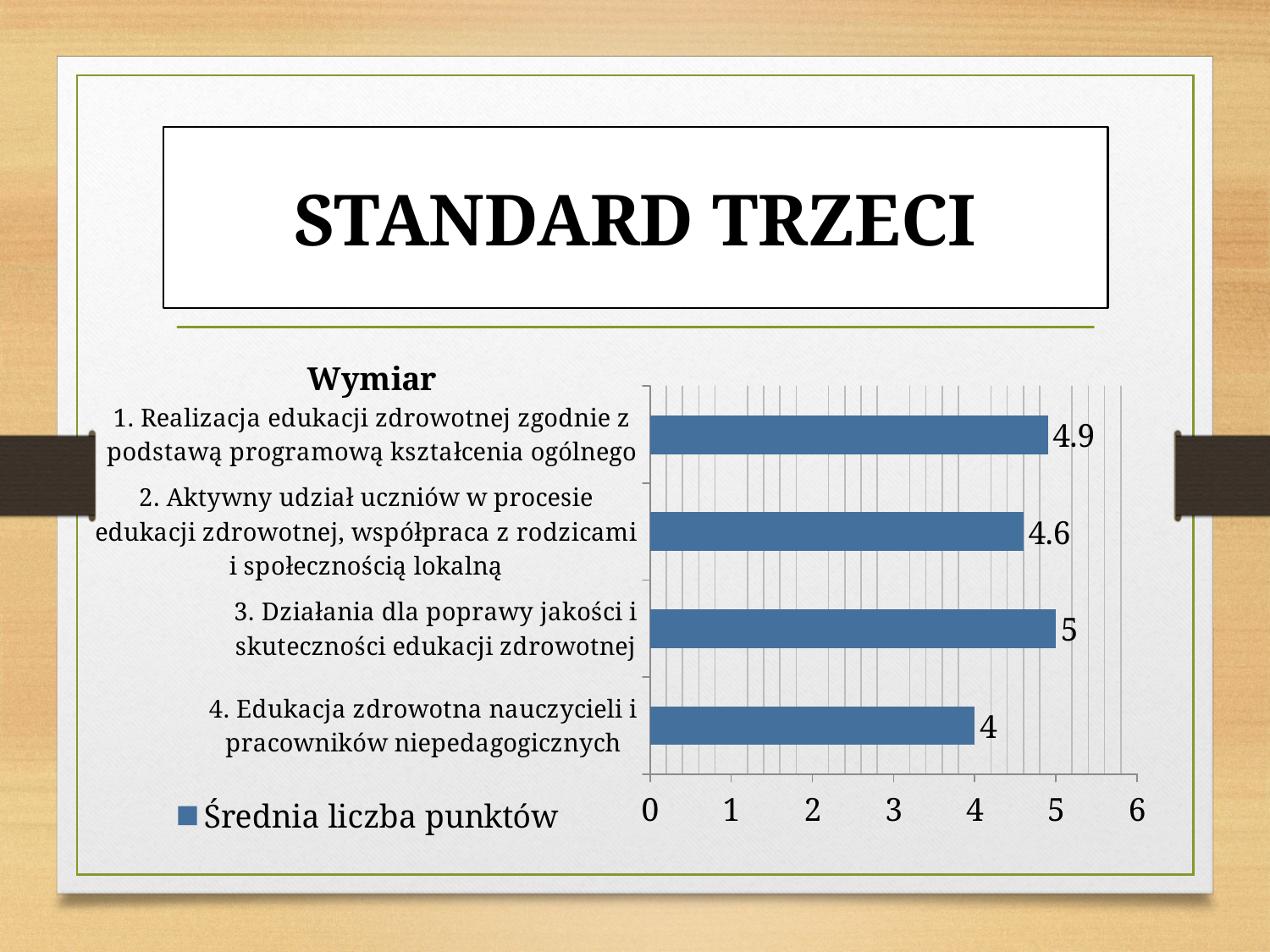
What is the average score (Średnia liczba punktów) for category 1, Realizacja edukacji zdrowotnej zgodnie z podstawą programową kształcenia ogólnego? 4.9 What is the difference between the values for category 1 and category 4? 0.9 What is the value for category 4, Edukacja zdrowotna nauczycieli i pracowników niepedagogicznych? 4 What is the name of the series shown in the legend? Średnia liczba punktów Which has a larger value: category 1 or category 2? 1. Realizacja edukacji zdrowotnej zgodnie z podstawą programową kształcenia ogólnego What is the value for category 2, Aktywny udział uczniów w procesie edukacji zdrowotnej, współpraca z rodzicami i społecznością lokalną? 4.6 What kind of chart is shown on the slide? Bar chart Which category has the highest average score? 3. Działania dla poprawy jakości i skuteczności edukacji zdrowotnej How many series does the legend list? 1 What is the value for category 3, Działania dla poprawy jakości i skuteczności edukacji zdrowotnej? 5 How many categories are shown in the chart? 4 Which category has the lowest average score? 4. Edukacja zdrowotna nauczycieli i pracowników niepedagogicznych